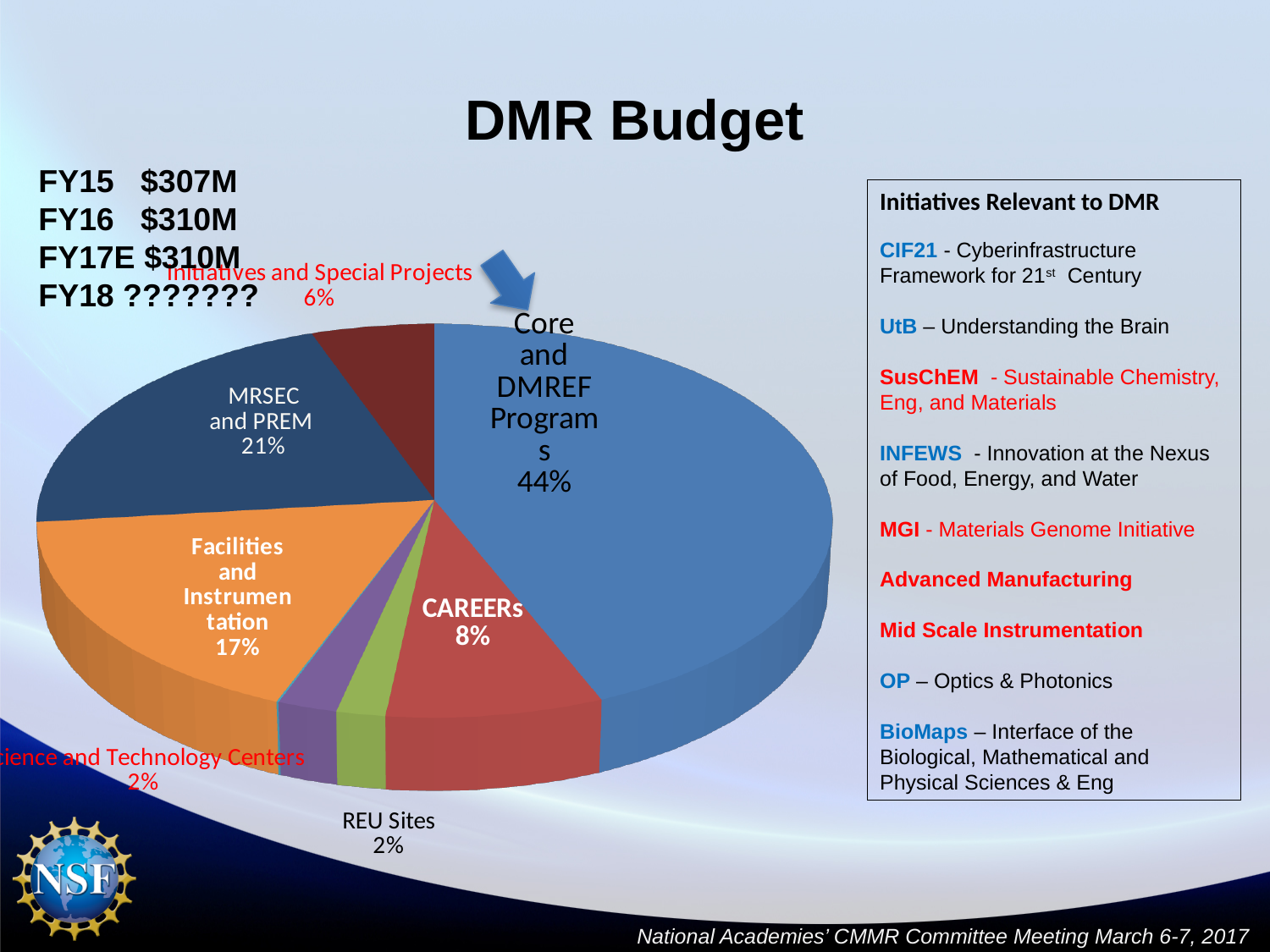
What is the value shown for REU Sites? 2% Which slice of the pie is the largest? Core and DMREF Programs What kind of chart is shown on the slide? pie chart What share of the pie does Facilities and Instrumentation represent? 17% What is the value shown for CAREERs? 8% How many slices does the pie chart have? 7 Which is larger, MRSEC and PREM or Facilities and Instrumentation? MRSEC and PREM What share of the pie does Core and DMREF Programs represent? 44% What is the value shown for Initiatives and Special Projects? 6% What is the title of the slide containing the pie chart? DMR Budget What is the difference between the Core and DMREF Programs share and the MRSEC and PREM share? 23% What share of the pie does MRSEC and PREM represent? 21%